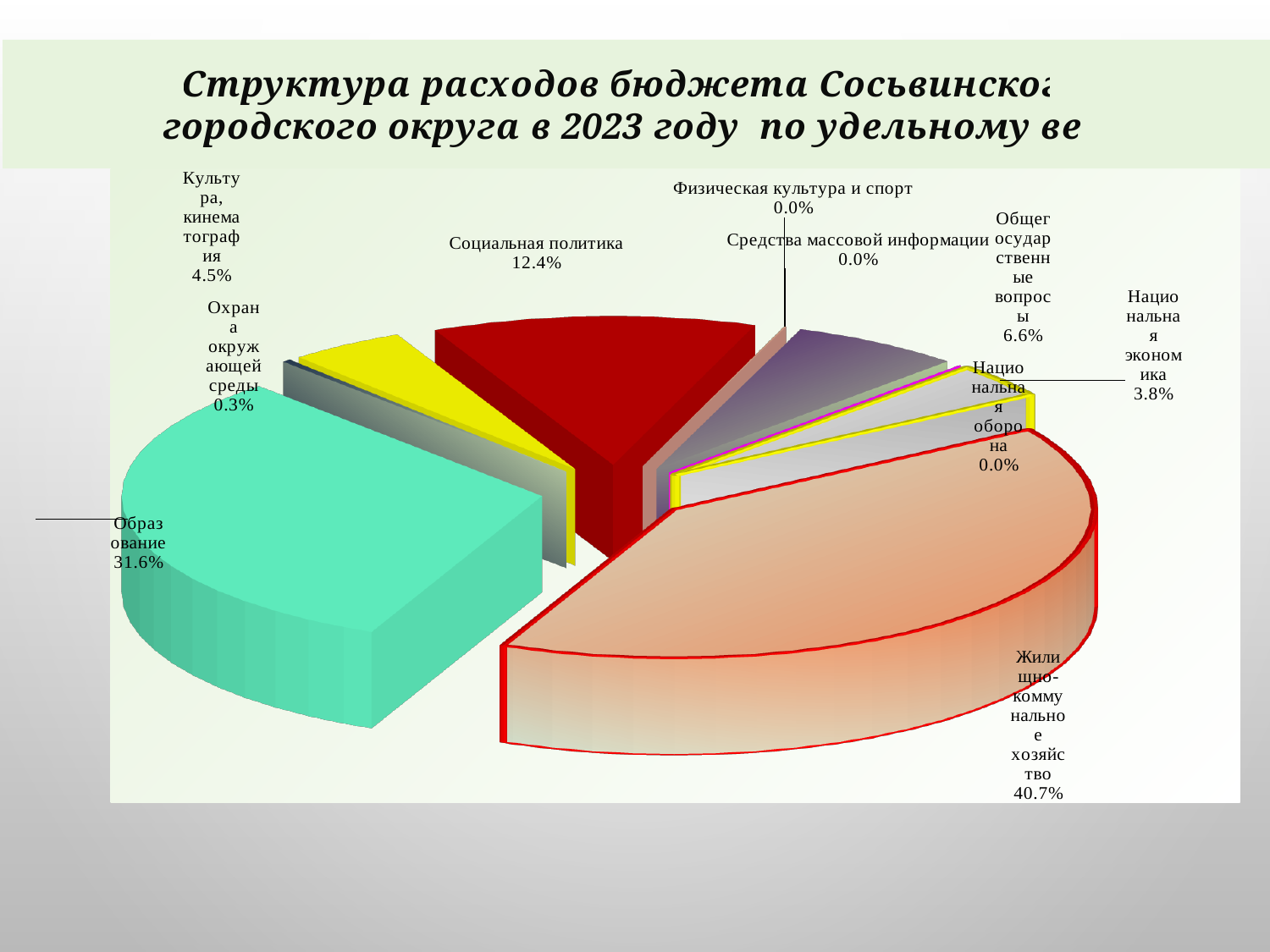
What is the difference between the shares of Жилищно-коммунальное хозяйство and Образование? 9.1% Which category has the largest share of the pie? Жилищно-коммунальное хозяйство What is the value shown for Национальная экономика? 3.8% What is the value shown for Общегосударственные вопросы? 6.6% What kind of chart is shown on the slide? Pie chart What is the value shown for Охрана окружающей среды? 0.3% Which year does the chart title say the budget expenditure structure refers to? 2023 What share of the pie does Жилищно-коммунальное хозяйство have? 40.7% How many categories are shown in the pie chart? 10 What is the value shown for Образование? 31.6% Which is larger, the share for Культура, кинематография or the share for Национальная экономика? Культура, кинематография What is the value shown for Социальная политика? 12.4%